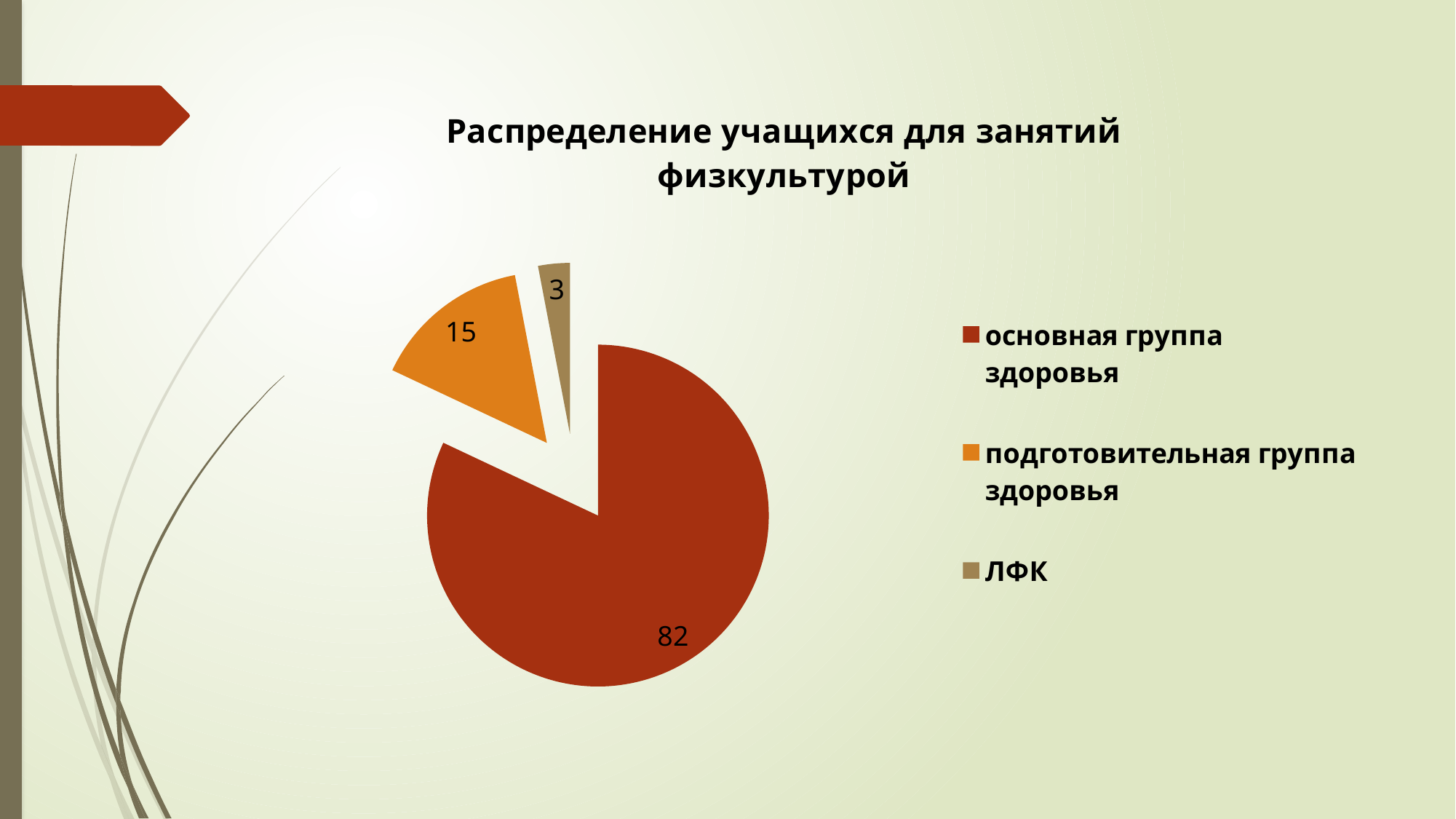
What type of chart is shown on the slide? pie chart Which is larger, the value for подготовительная группа здоровья or the value for ЛФК? подготовительная группа здоровья Which category has the largest slice? основная группа здоровья What colour is the slice for ЛФК? brown What is the value for ЛФК? 3 Which category has the smallest slice? ЛФК How many categories does the pie chart have? 3 What is the title of the chart? Распределение учащихся для занятий физкультурой What is the value for основная группа здоровья? 82 What is the value for подготовительная группа здоровья? 15 What is the difference between the values for подготовительная группа здоровья and ЛФК? 12 What is the difference between the values for основная группа здоровья and подготовительная группа здоровья? 67